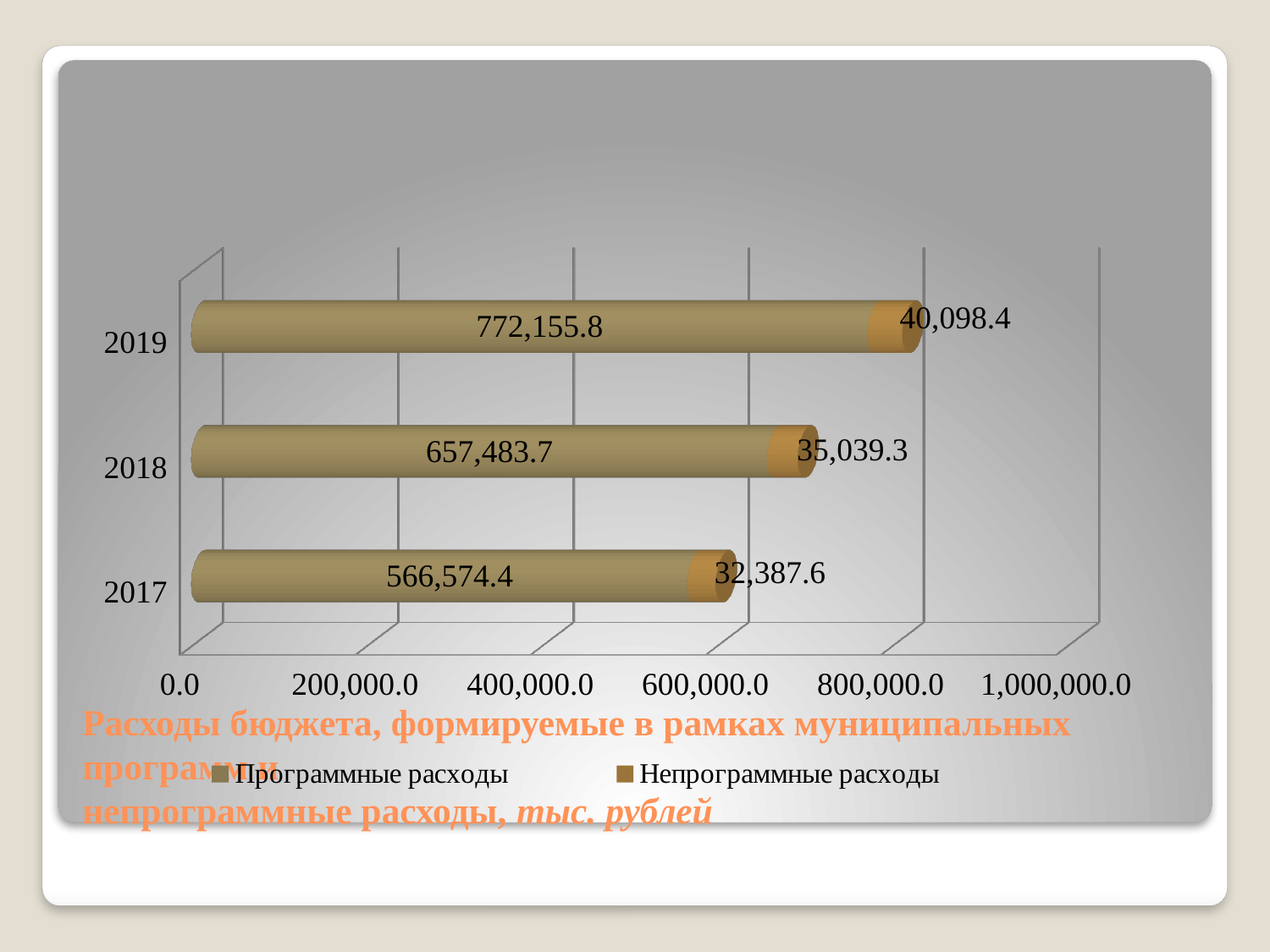
What is the value of Программные расходы for 2019? 772,155.8 Which year has the highest Программные расходы? 2019 What is the difference between Программные расходы in 2019 and 2018? 114,672.1 How many series does the legend list? 2 How many years are shown on the chart? 3 Which year has the lowest Непрограммные расходы? 2017 What is the value of Непрограммные расходы for 2017? 32,387.6 Which is larger: Программные расходы in 2017 or Непрограммные расходы in 2019? Программные расходы in 2017 What is the value of Программные расходы for 2018? 657,483.7 What kind of chart is shown on the slide? Stacked bar chart What is the total of the stacked bar for 2019? 812,254.2 What is the difference between Непрограммные расходы in 2018 and 2017? 2,651.7